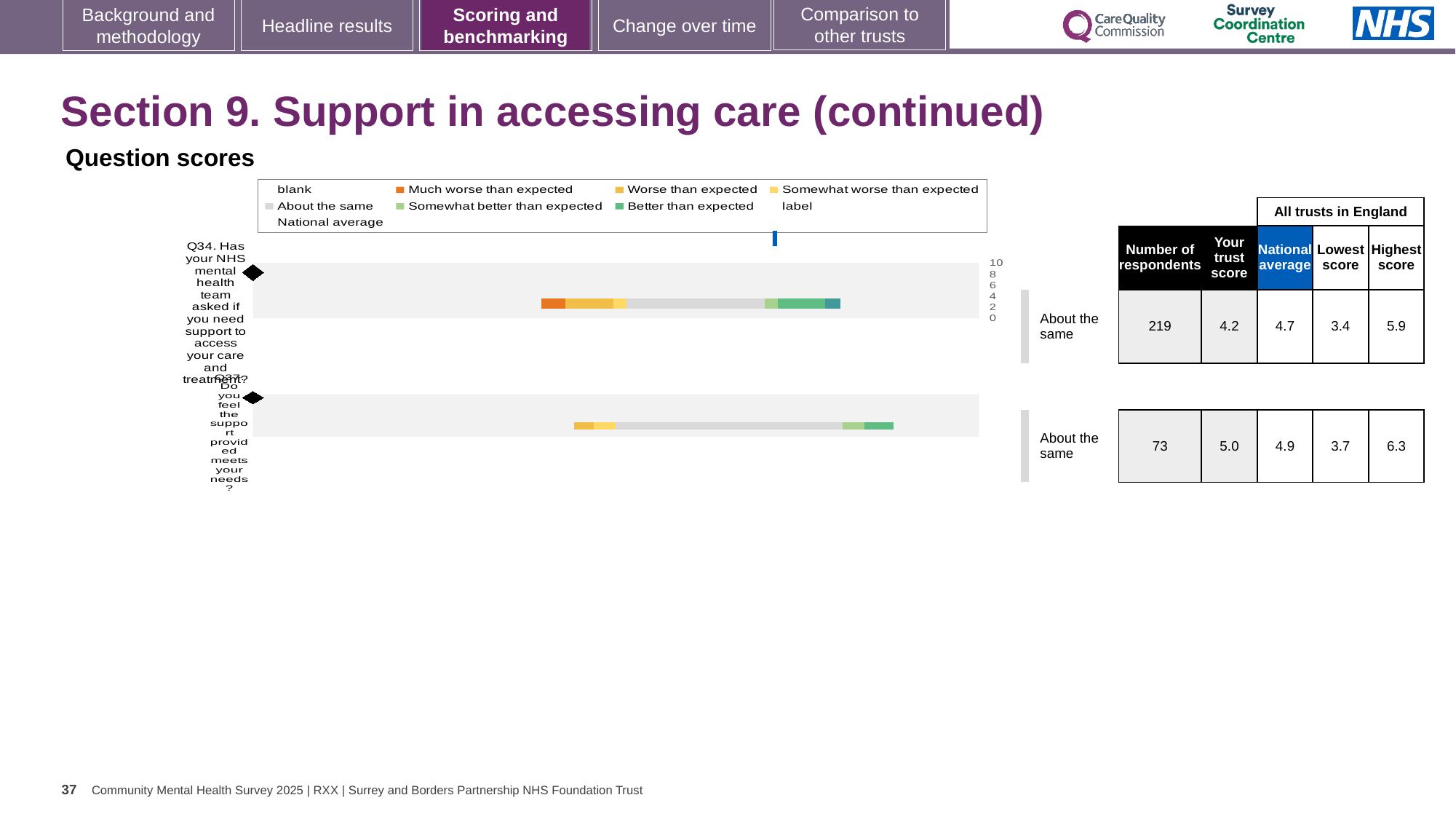
For Q34, which is larger: the trust score or the national average? national average What is the highest score among all trusts in England for Q37? 6.3 What benchmark category is shown for Q34? About the same What kind of chart is used to show the question scores on this slide? bar chart What is the trust score for Q37 (Do you feel the support provided meets your needs)? 5.0 What is the national average score for Q34? 4.7 Which question has the higher trust score, Q34 or Q37? Q37 How many respondents answered Q37? 73 Which colour in the legend represents 'Much worse than expected'? orange How many questions (categories) are plotted in the question scores chart? 2 What is the difference between the national average and the trust score for Q34? 0.5 What is the trust score for Q34 (Has your NHS mental health team asked if you need support to access your care and treatment)? 4.2